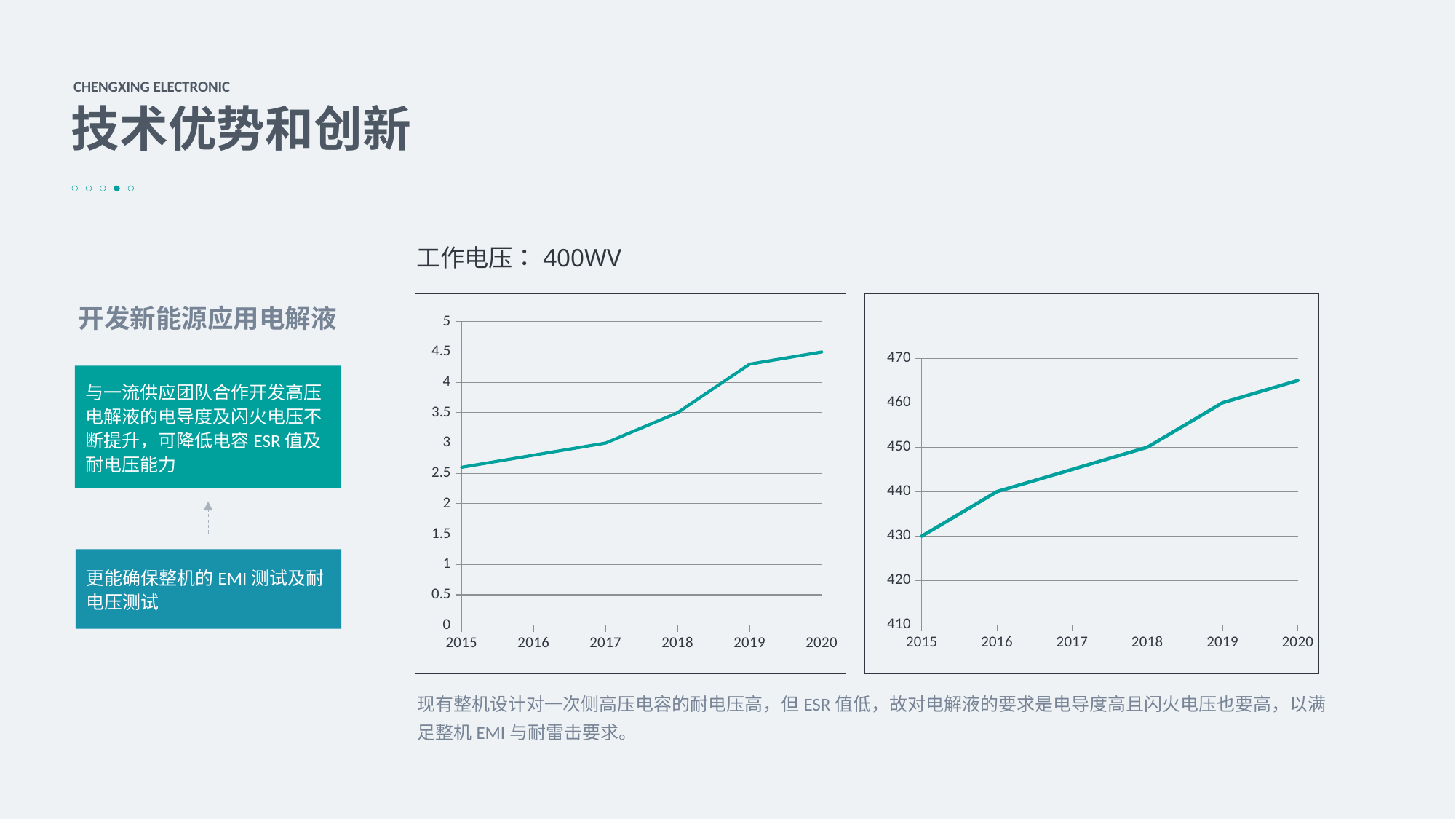
In the right chart, which year has the highest value? 2020 In the right chart, what is the value for 2015? 430 In the right chart, is the value for 2017 greater or less than 450? less How many years are plotted on the x axis of the right chart? 6 In the right chart, what is the difference between the values for 2018 and 2016? 10 In the left chart, is the value for 2019 greater or less than 4? greater In the right chart, which is larger, the value for 2016 or the value for 2019? 2019 In the left chart, do the values rise or fall from 2015 to 2020? rise In the left chart, what is the value for 2018? 3.5 In the left chart, what is the value for 2017? 3 What kind of chart is the left chart on the slide? line chart In the left chart, which year has the lowest value? 2015